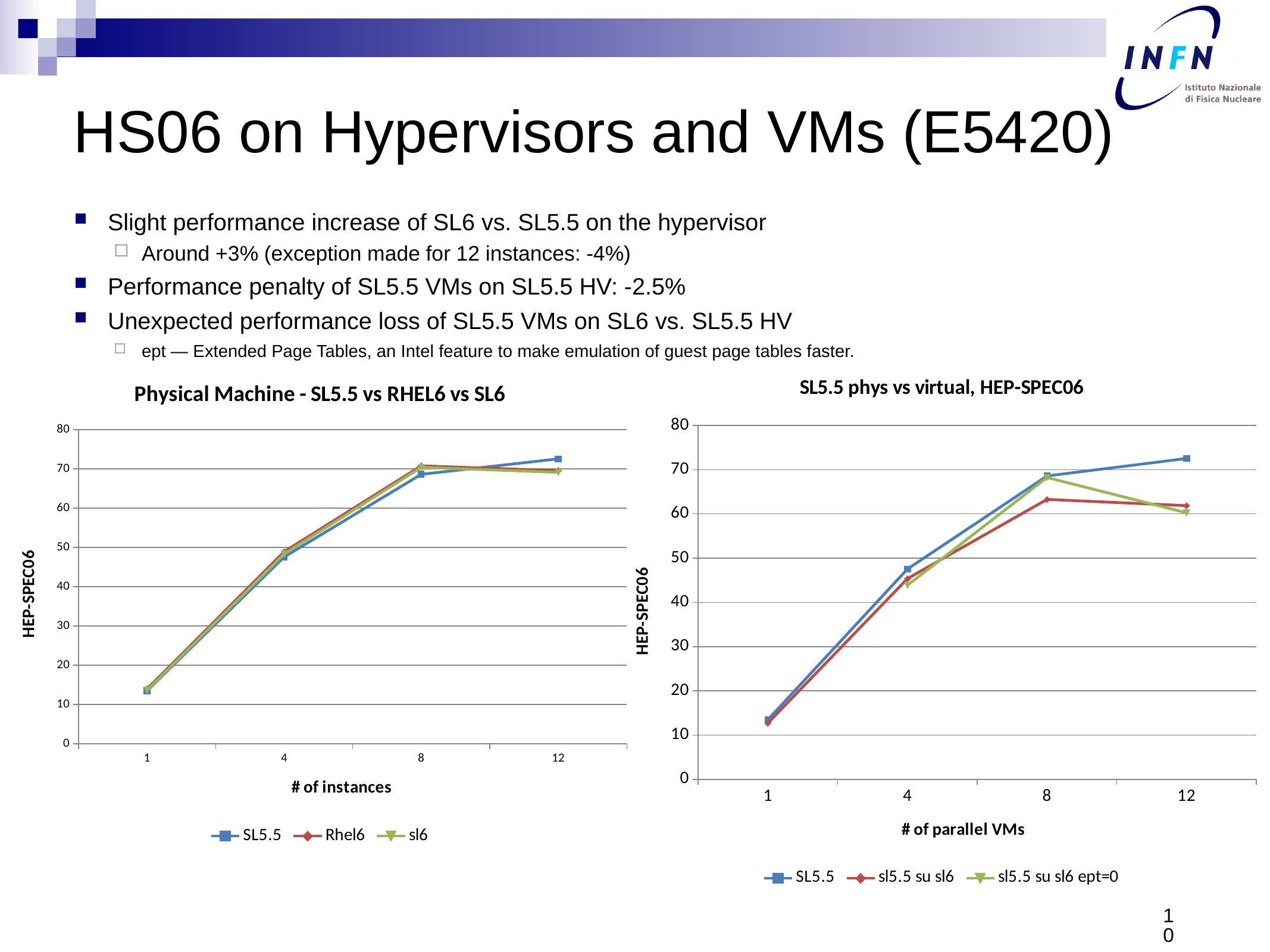
How many x-axis categories (# of instances) are plotted in the left chart "Physical Machine - SL5.5 vs RHEL6 vs SL6"? 4 In the right chart "SL5.5 phys vs virtual, HEP-SPEC06", does the SL5.5 series rise or fall as the number of parallel VMs increases from 1 to 12? rise In the left chart "Physical Machine - SL5.5 vs RHEL6 vs SL6", is the Rhel6 value at 1 instance greater or less than 20? less What is the x-axis label of the left chart "Physical Machine - SL5.5 vs RHEL6 vs SL6"? # of instances How many series does the legend of the right chart "SL5.5 phys vs virtual, HEP-SPEC06" list? 3 In the right chart "SL5.5 phys vs virtual, HEP-SPEC06", which series has the higher value at 12 parallel VMs: SL5.5 or "sl5.5 su sl6"? SL5.5 What kind of chart is the left chart titled "Physical Machine - SL5.5 vs RHEL6 vs SL6"? line chart In the left chart "Physical Machine - SL5.5 vs RHEL6 vs SL6", is the SL5.5 value at 12 instances greater or less than 70? greater In the right chart "SL5.5 phys vs virtual, HEP-SPEC06", does the "sl5.5 su sl6 ept=0" series rise or fall between 8 and 12 parallel VMs? fall What is the y-axis label of the right chart "SL5.5 phys vs virtual, HEP-SPEC06"? HEP-SPEC06 In the right chart "SL5.5 phys vs virtual, HEP-SPEC06", is the "sl5.5 su sl6 ept=0" value at 12 parallel VMs greater or less than 70? less In the left chart "Physical Machine - SL5.5 vs RHEL6 vs SL6", which series has the higher value at 12 instances: SL5.5 or sl6? SL5.5